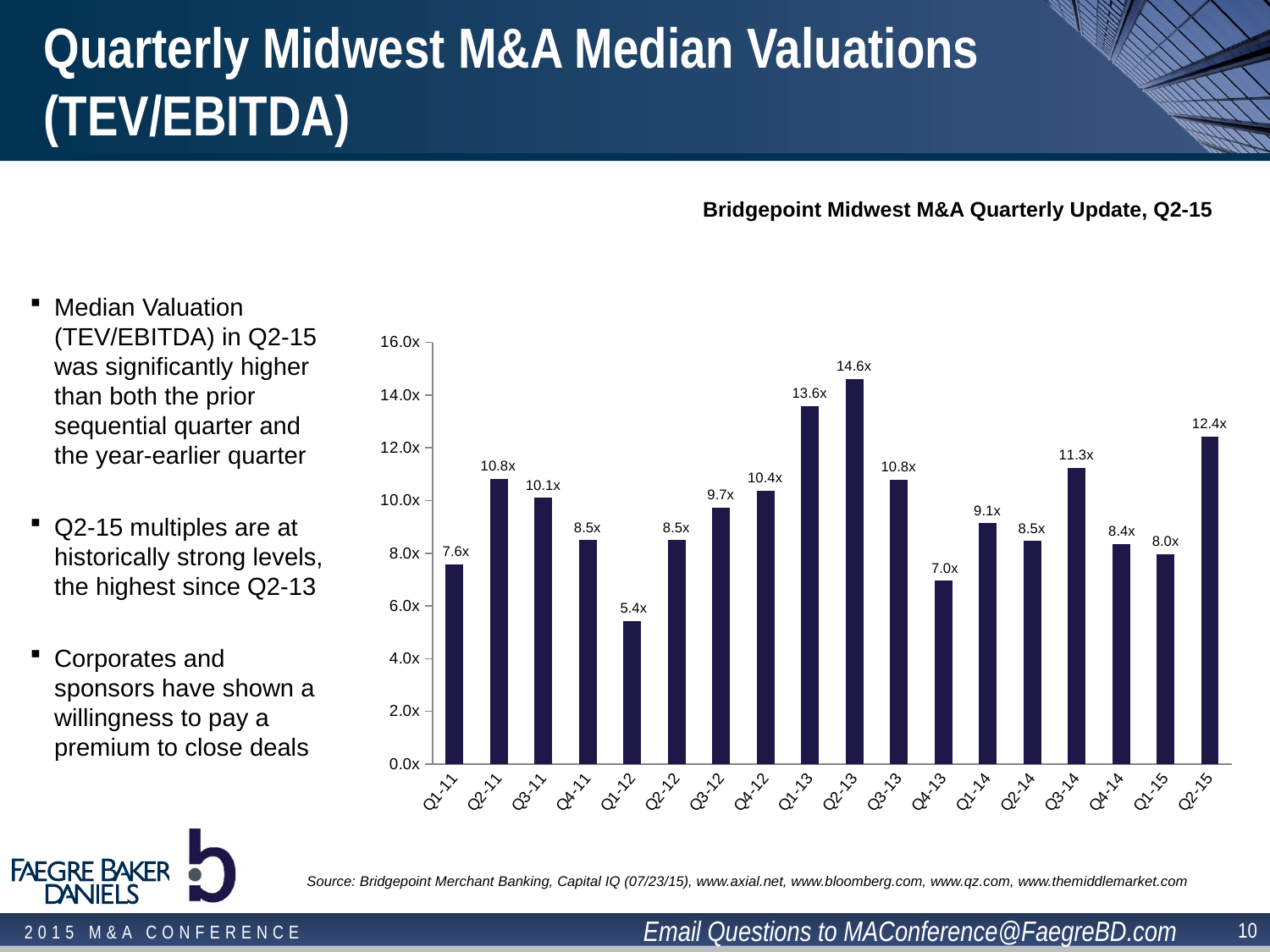
What is the median valuation (TEV/EBITDA) for Q2-15? 12.4x What is the highest tick value shown on the y axis? 16.0x What is the difference between the Q2-13 and Q1-13 median valuations? 1.0x How much higher is the Q2-15 median valuation than the Q1-15 median valuation? 4.4x What is the median valuation for Q1-12? 5.4x Do the median valuations rise or fall from Q1-12 to Q2-13? rise Which quarter has the lowest median valuation? Q1-12 Is the value for Q4-13 greater or less than 8.0x? less Which quarter has the highest median valuation? Q2-13 Which is larger, the median valuation for Q1-13 or for Q3-14? Q1-13 How many quarters are plotted on the chart? 18 What kind of chart is shown on the slide? bar chart